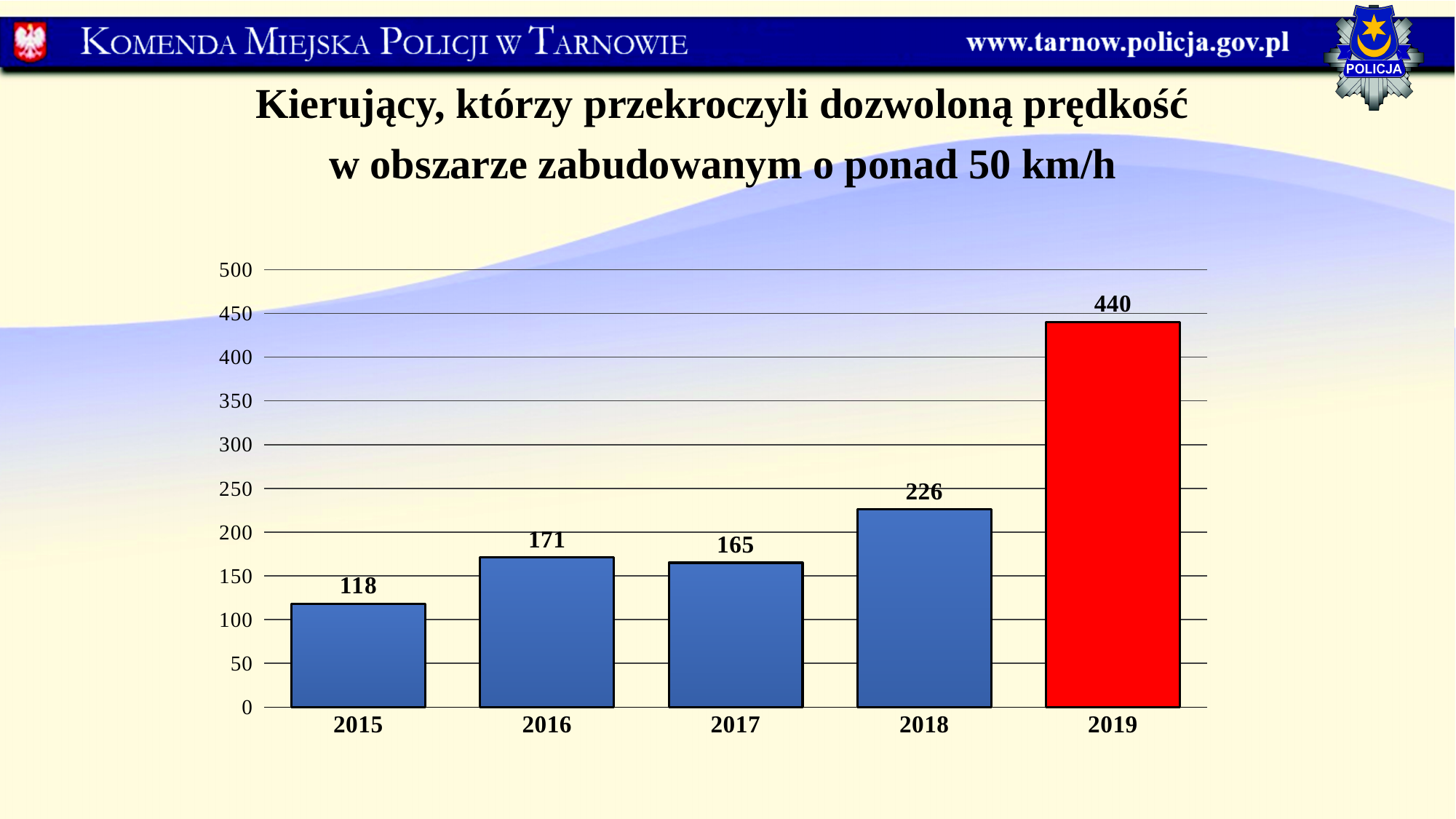
Which year has the highest value? 2019 Which bar is coloured red rather than blue? 2019 What is the value for 2015? 118 How many years are shown on the x axis? 5 What kind of chart is shown on the slide? bar chart What is the value for 2017? 165 Is the value for 2018 greater or less than 200? greater Which is larger, the value for 2016 or the value for 2018? 2018 What is the difference between the values for 2019 and 2018? 214 What is the value for 2019? 440 What is the difference between the values for 2016 and 2017? 6 Which year has the lowest value? 2015